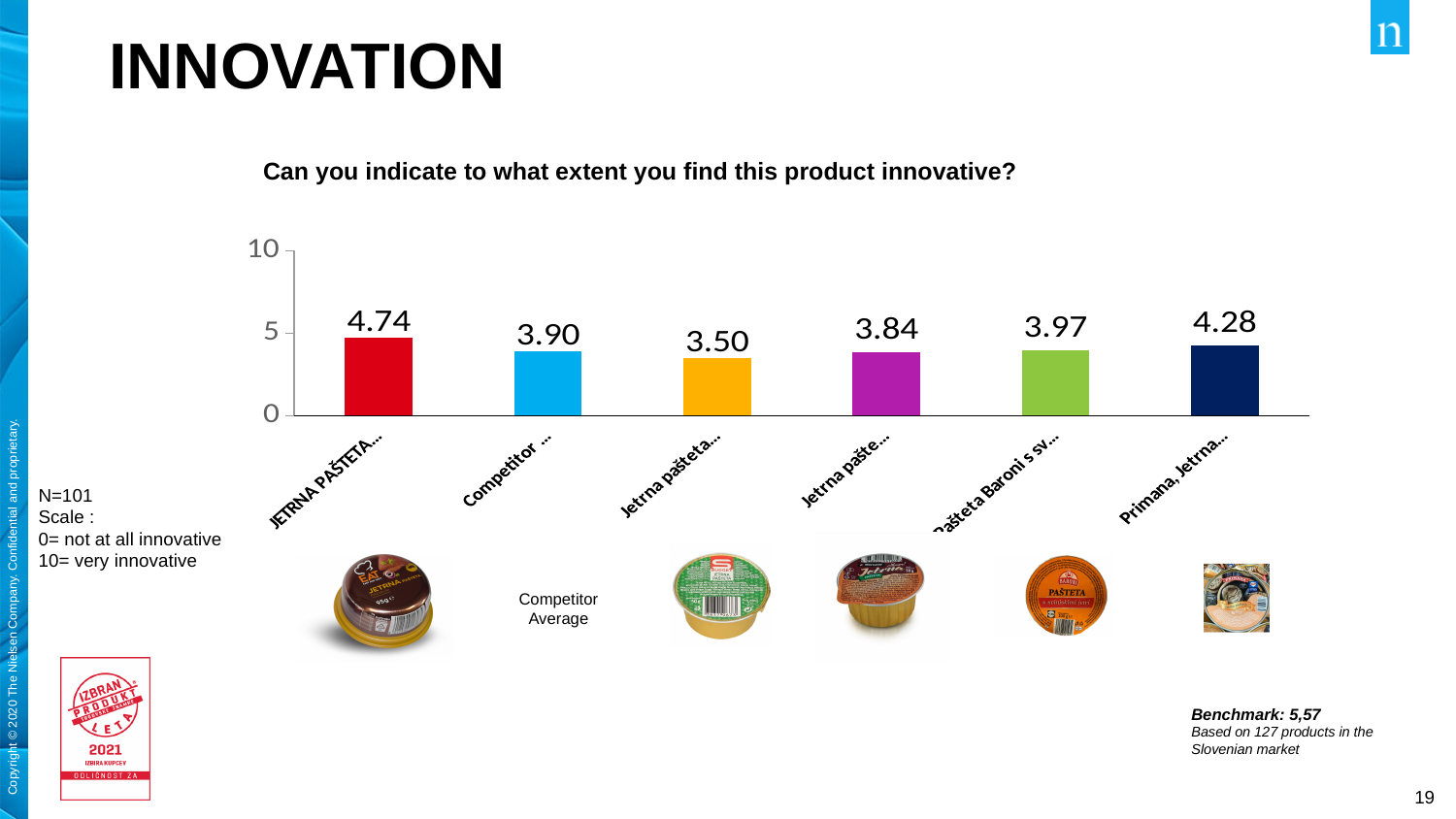
What is the difference between the first bar (4.74) and the Competitor Average bar (3.90)? 0.84 Which bar has the highest innovation score? JETRNA PAŠTETA... (the first, red bar) Which is larger: the value for "Primana, Jetrna..." or the value for "Pašteta Baroni s sv..."? Primana, Jetrna... What value is shown for the first (red) bar, labelled "JETRNA PAŠTETA..."? 4.74 What value is shown for the bar labelled "Pašteta Baroni s sv..."? 3.97 Is the value for the Competitor Average bar greater or less than 5? less What value is shown for the bar labelled "Primana, Jetrna..."? 4.28 What benchmark value is stated on the slide? 5,57 How many bars are shown in the chart? 6 What type of chart is shown on the slide? bar chart What is the innovation score for the Competitor Average bar? 3.90 What is the lowest value shown in the chart? 3.50